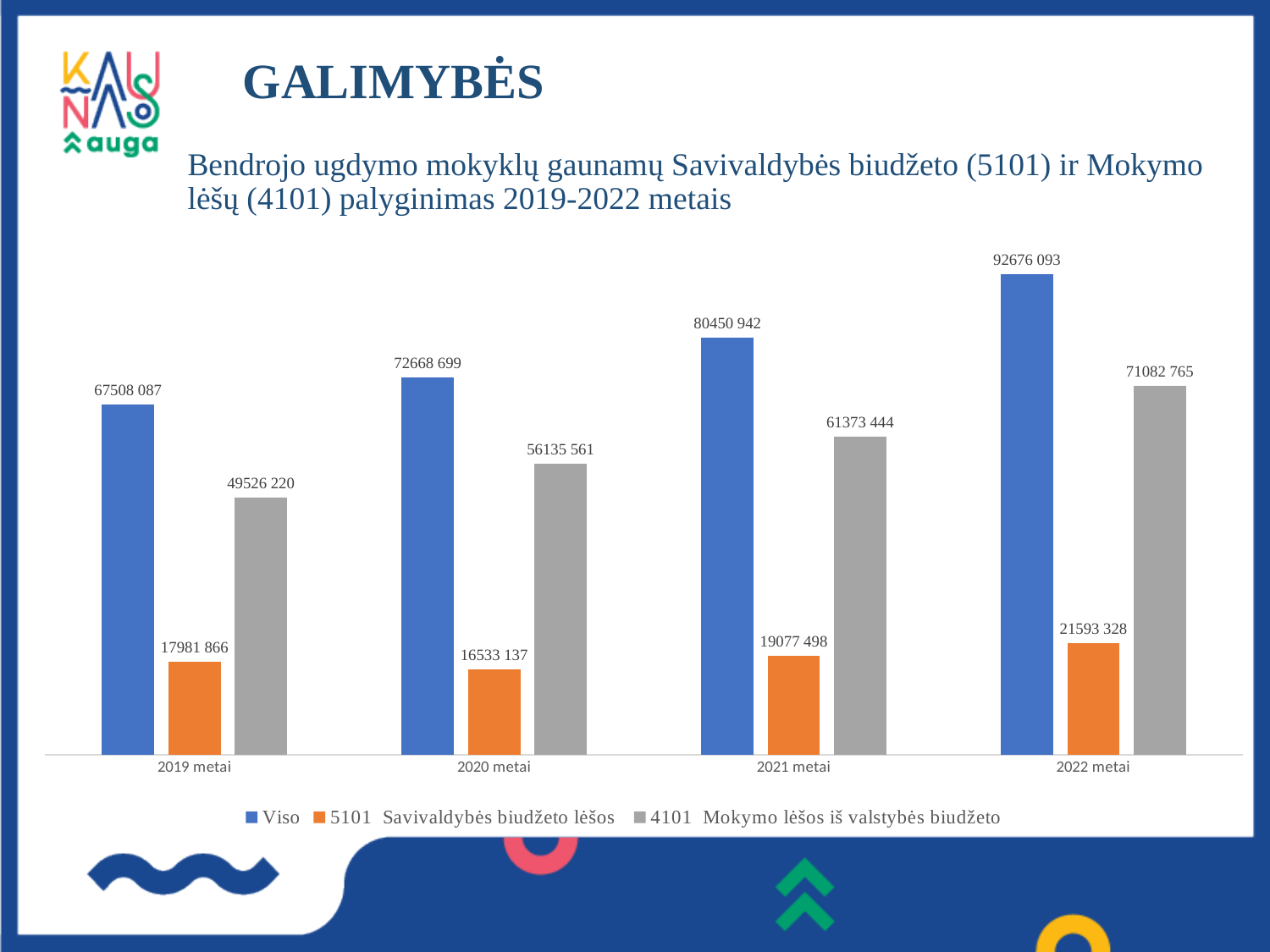
How many year categories are shown on the x axis? 4 How many series does the legend list? 3 In which year is the 5101 Savivaldybės biudžeto lėšos value lowest? 2020 metai What is the value of 5101 Savivaldybės biudžeto lėšos for 2019 metai? 17981 866 Which colour represents the Viso series in the chart? Blue Do the Viso values rise or fall from 2019 metai to 2022 metai? Rise In which year is the Viso value highest? 2022 metai What is the value of Viso for 2021 metai? 80450 942 Which is larger: the 4101 Mokymo lėšos iš valstybės biudžeto value for 2021 metai or for 2022 metai? 2022 metai What is the difference between the Viso value for 2022 metai and for 2019 metai? 25168 006 What kind of chart is shown on the slide? Bar chart What is the value of 4101 Mokymo lėšos iš valstybės biudžeto for 2020 metai? 56135 561